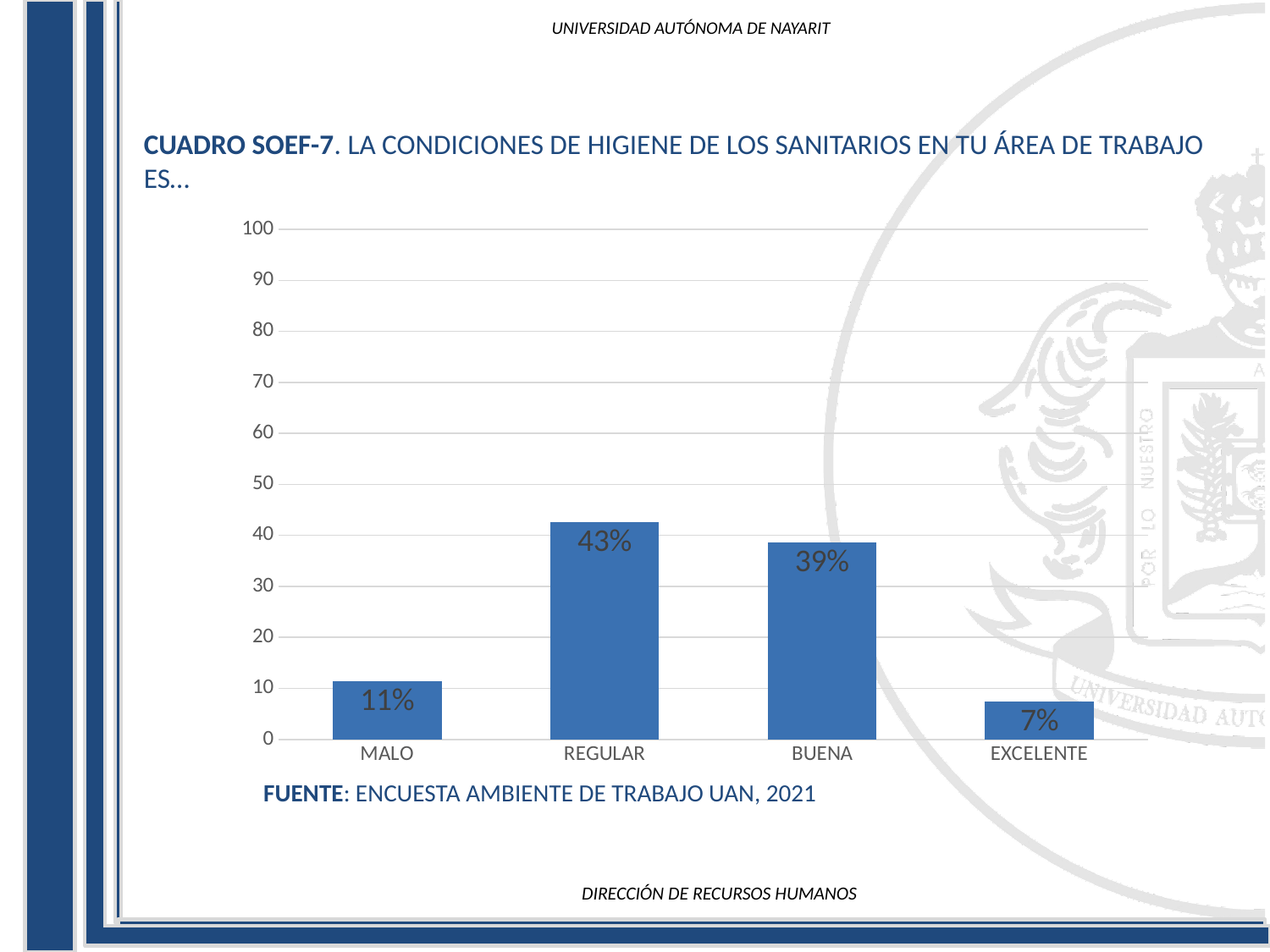
What source is cited below the chart? ENCUESTA AMBIENTE DE TRABAJO UAN, 2021 Which category has the lowest value? EXCELENTE How many categories are shown on the x axis? 4 What is the value for MALO? 11% What is the value for EXCELENTE? 7% What is the difference between the values for MALO and EXCELENTE? 4% What is the difference between the values for REGULAR and BUENA? 4% What is the value for REGULAR? 43% Which category has the highest value? REGULAR What is the value for BUENA? 39% Which is larger, the value for MALO or the value for BUENA? BUENA What kind of chart is shown on the slide? Bar chart